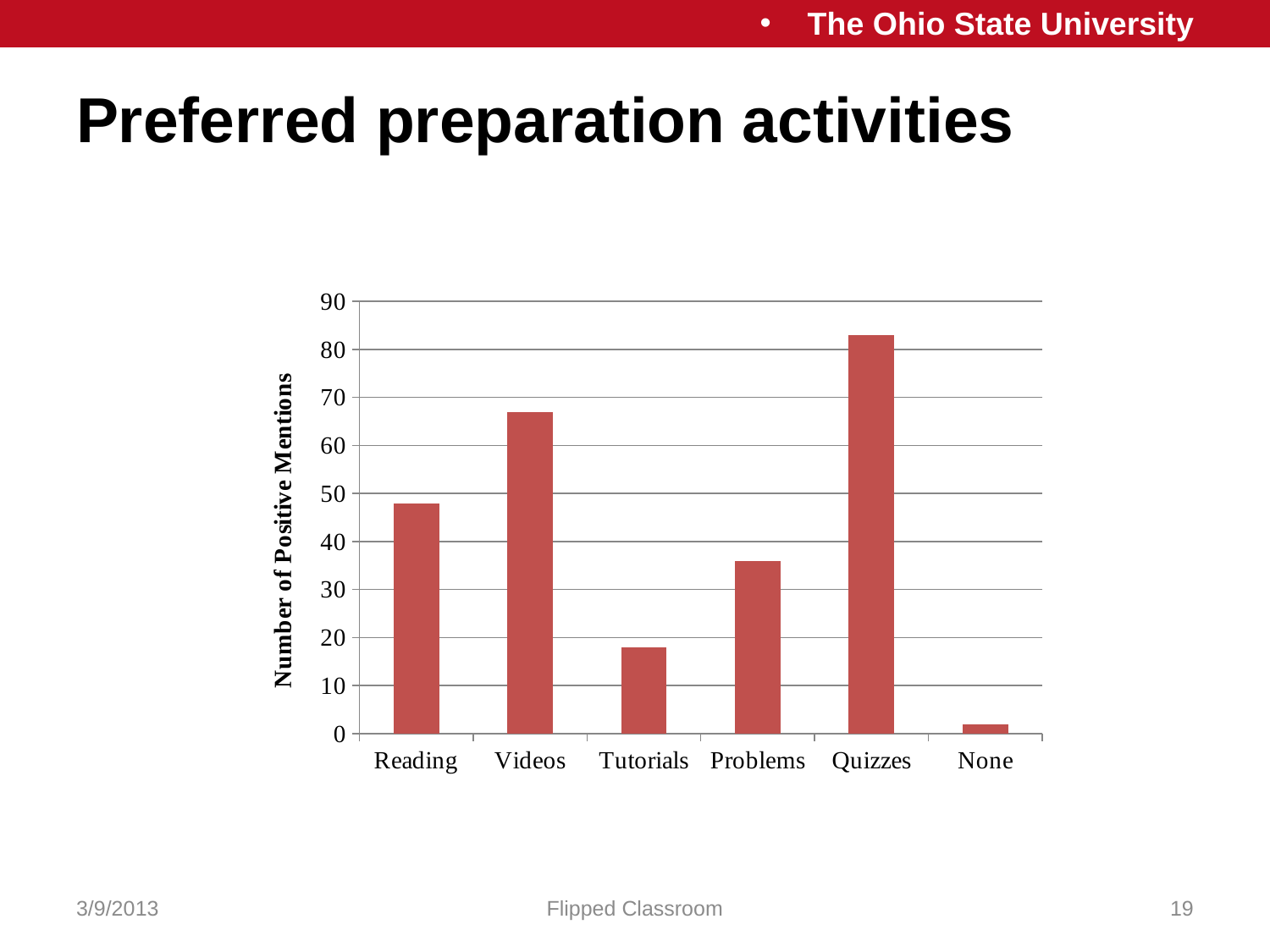
Which has more positive mentions, Tutorials or Problems? Problems Is the value for Problems greater or less than 30? greater Which category has the lowest number of positive mentions? None Which has more positive mentions, Reading or Videos? Videos What is the label of the vertical axis? Number of Positive Mentions What type of chart is shown on the slide? bar chart Is the value for Videos greater or less than 70? less How many categories are shown on the x axis? 6 Is the value for Quizzes greater or less than 80? greater Which category has the highest number of positive mentions? Quizzes